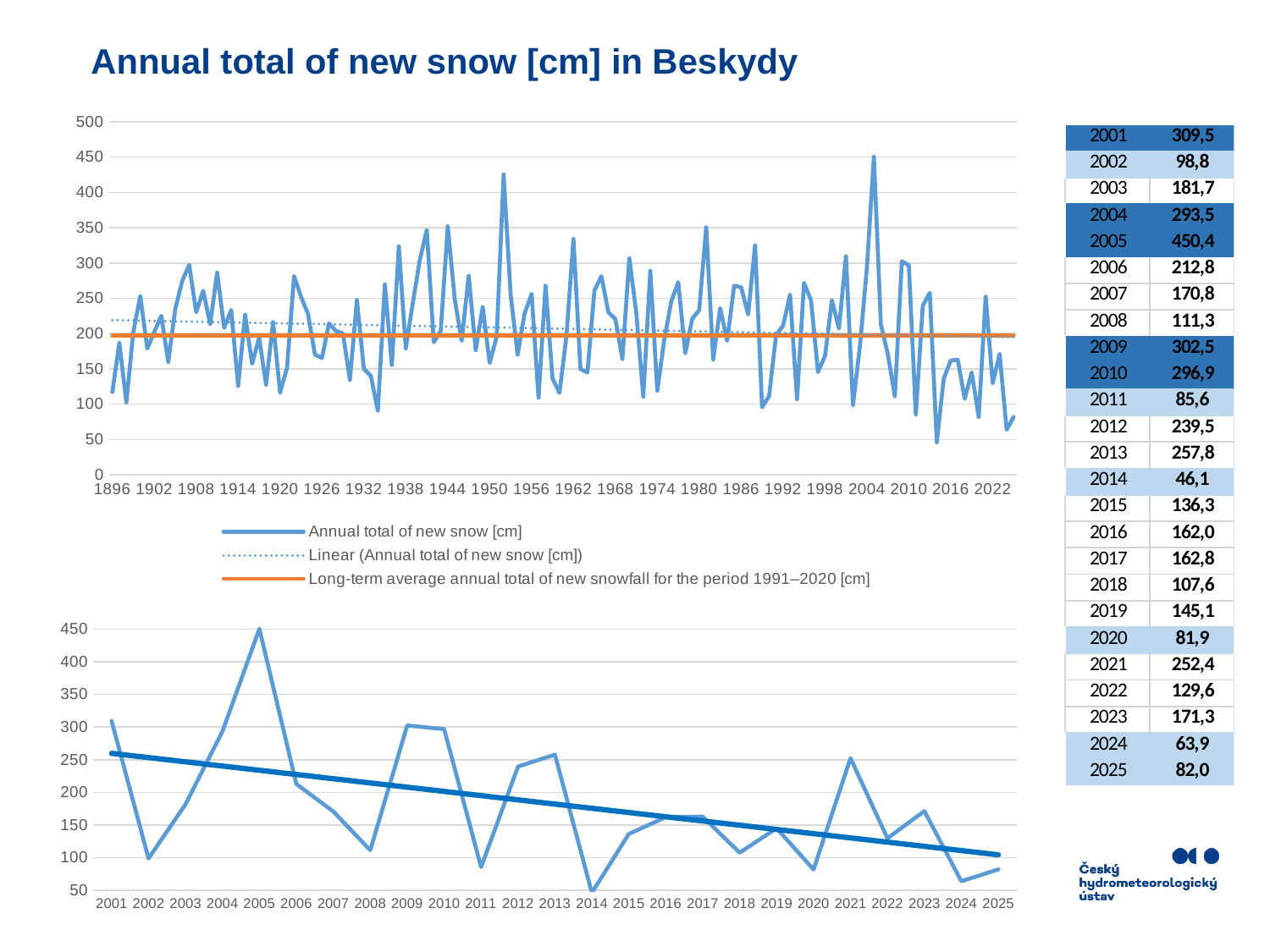
In the bottom chart (2001–2025), does the straight trend line rise or fall from 2001 to 2025? fall In the bottom chart (2001–2025), what is the annual total of new snow for 2005? 450,4 In the top chart, which year has the highest annual total of new snow? 2005 In the top chart, is the value for 1896 greater or less than 150? less How many series does the legend of the top chart list? 3 In the bottom chart (2001–2025), what is the annual total of new snow for 2025? 82,0 What is the title of the slide's chart? Annual total of new snow [cm] in Beskydy What kind of chart is the top chart on the slide? line chart In the bottom chart (2001–2025), what is the difference between the values for 2005 and 2014? 404,3 In the bottom chart (2001–2025), which year has the lowest annual total of new snow? 2014 In the bottom chart (2001–2025), which year has the larger value, 2001 or 2002? 2001 How many years are plotted in the bottom chart (2001–2025)? 25